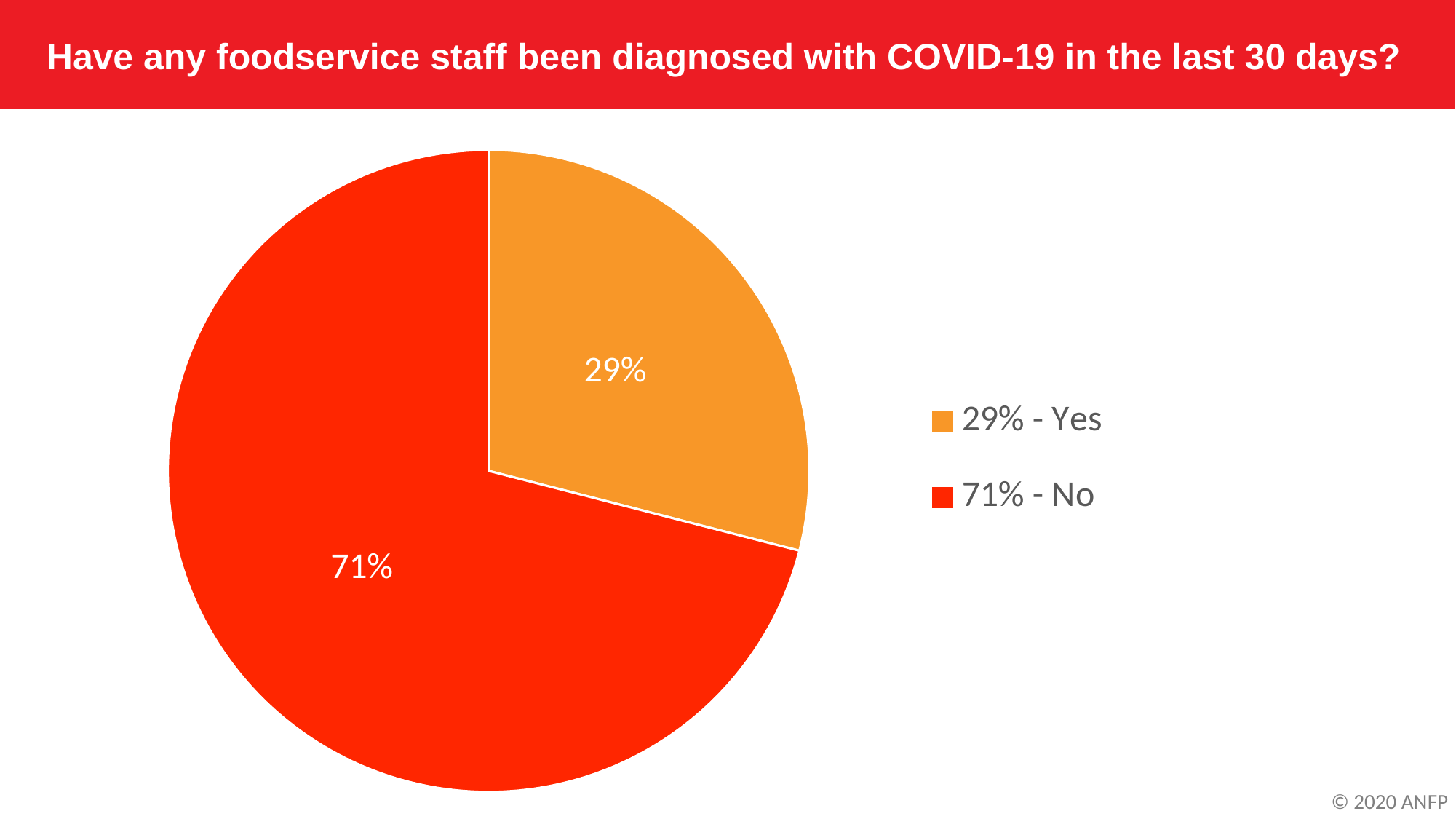
How many slices does the pie chart have? 2 Which response has the largest share of the pie? No What colour is the slice representing No? red Which response has the smallest share of the pie? Yes What percentage of respondents answered Yes? 29% What share of the pie does the Yes slice represent? 29% What is the difference in percentage points between the No and Yes responses? 42 What percentage of respondents answered No? 71% What is the title of the chart? Have any foodservice staff been diagnosed with COVID-19 in the last 30 days? What type of chart is shown on the slide? pie chart Which is larger, the share for Yes or the share for No? No How many entries does the legend list? 2